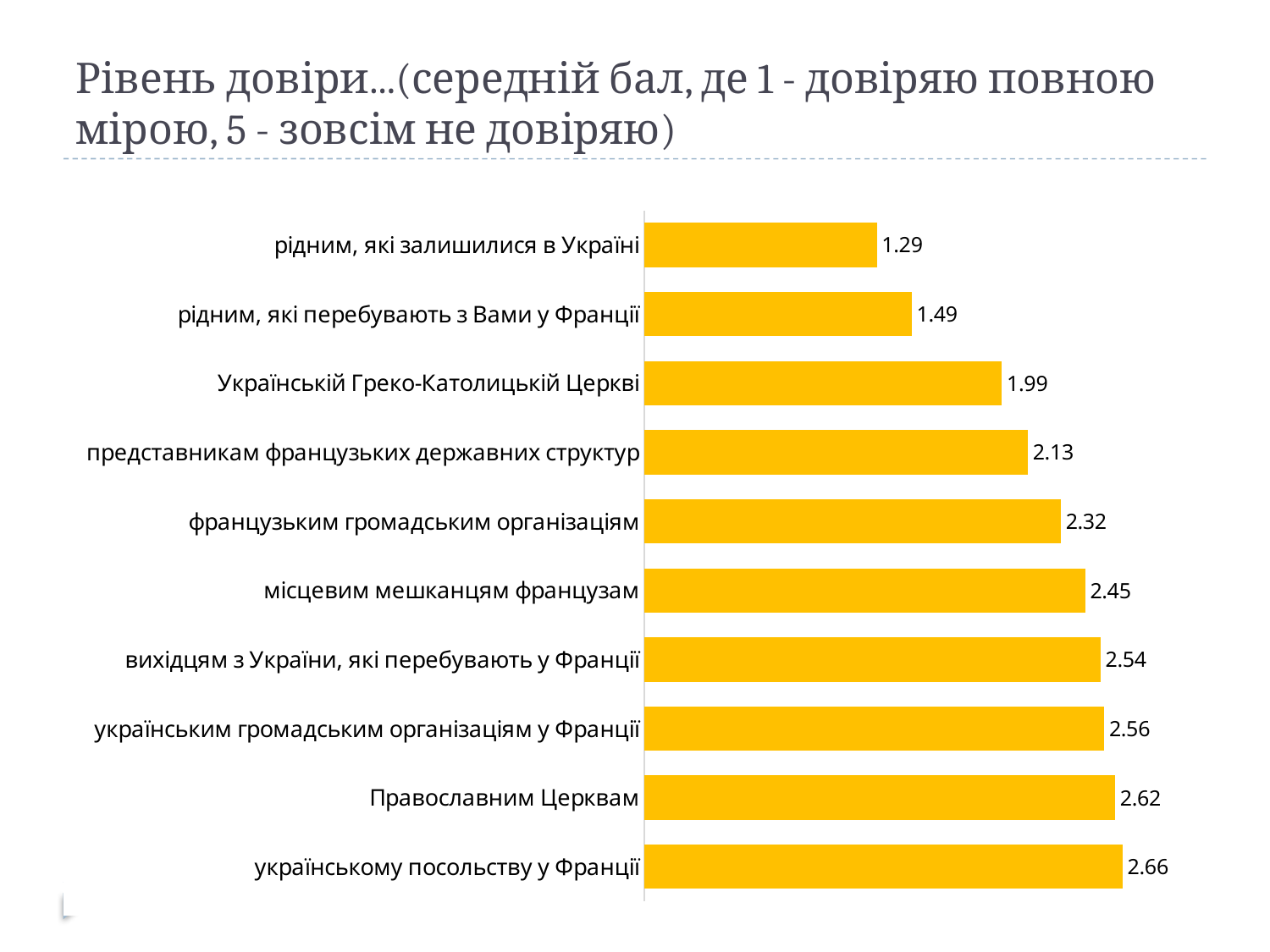
How many categories are shown in the chart? 10 What is the value for "Українській Греко-Католицькій Церкві"? 1.99 Which category has the highest value? українському посольству у Франції Which is larger: the value for "французьким громадським організаціям" or for "рідним, які перебувають з Вами у Франції"? французьким громадським організаціям What is the value for "рідним, які залишилися в Україні"? 1.29 What is the value for "Православним Церквам"? 2.62 Do the bar values increase or decrease from the top of the chart to the bottom? increase Which category has the lowest value? рідним, які залишилися в Україні What is the value for "місцевим мешканцям французам"? 2.45 What is the difference between the values for "українському посольству у Франції" and "рідним, які залишилися в Україні"? 1.37 What kind of chart is shown on the slide? bar chart What is the difference between the values for "представникам французьких державних структур" and "Українській Греко-Католицькій Церкві"? 0.14